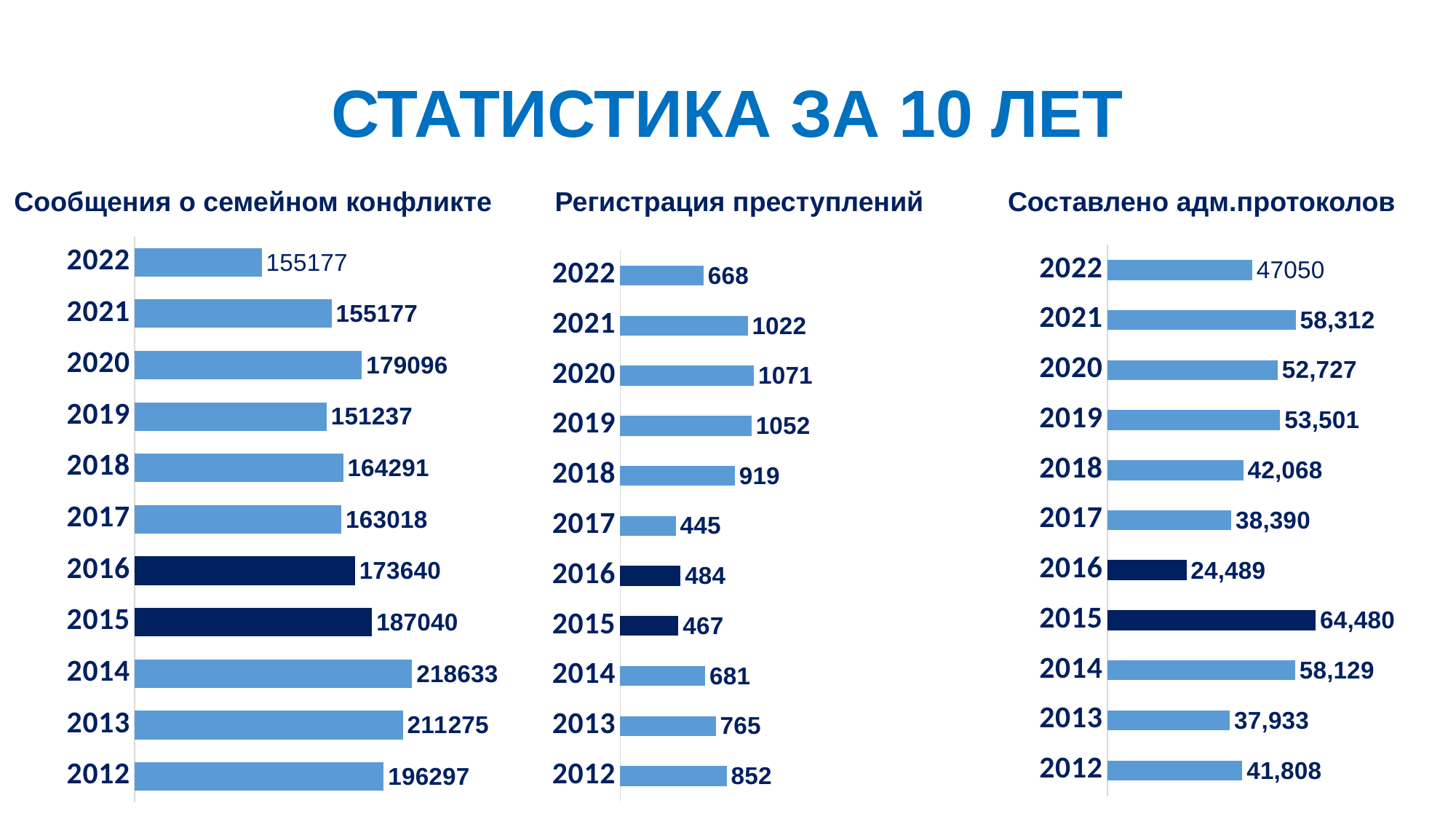
In the chart 'Регистрация преступлений', which year has the lowest value? 2017 In the chart 'Регистрация преступлений', what is the value for 2018? 919 In the chart 'Сообщения о семейном конфликте', which year has the highest value? 2014 In the chart 'Сообщения о семейном конфликте', what is the value for 2020? 179096 In the chart 'Составлено адм.протоколов', which year has the lowest value? 2016 What type of chart is used for 'Сообщения о семейном конфликте'? Bar chart How many years are shown in the chart 'Регистрация преступлений'? 11 In the chart 'Сообщения о семейном конфликте', what is the difference between the values for 2014 and 2013? 7358 In the chart 'Регистрация преступлений', what is the difference between the values for 2020 and 2019? 19 In the chart 'Составлено адм.протоколов', what is the value for 2017? 38,390 In the chart 'Составлено адм.протоколов', which year has the highest value? 2015 In the chart 'Составлено адм.протоколов', which is larger, the value for 2021 or the value for 2014? 2021